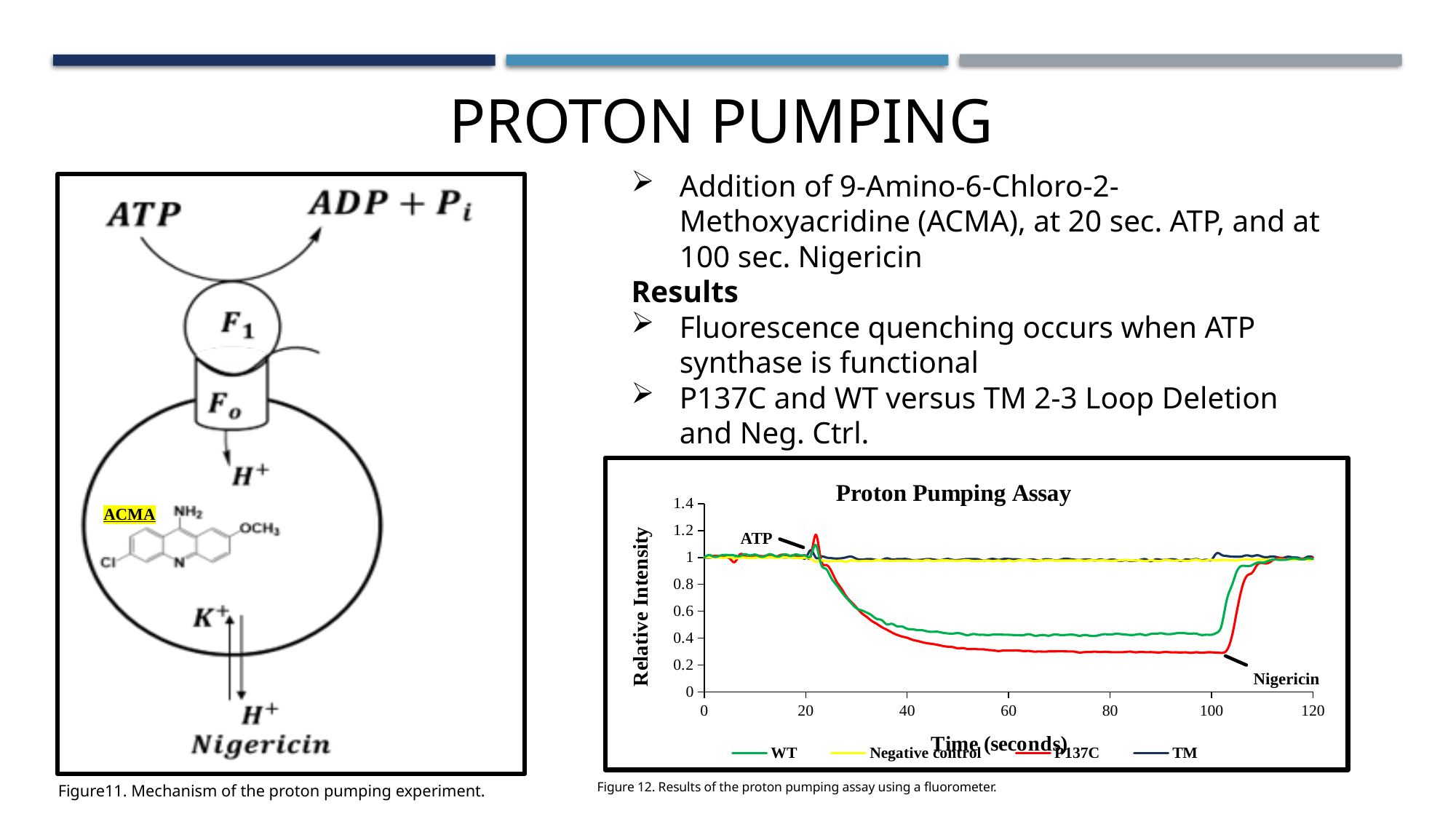
In the Proton Pumping Assay chart, is the value for WT at 60 seconds greater or less than 0.6? less In the Proton Pumping Assay chart, which is higher at 60 seconds, WT or P137C? WT In the Proton Pumping Assay chart, is the value for TM at 80 seconds greater or less than 0.6? greater In the Proton Pumping Assay chart, is the value for P137C at 60 seconds greater or less than 0.4? less What kind of chart is the Proton Pumping Assay? line chart What is the title of the chart on the slide? Proton Pumping Assay What is the label of the x axis of the Proton Pumping Assay chart? Time (seconds) How many series does the legend of the Proton Pumping Assay chart list? 4 In the Proton Pumping Assay chart, does the WT series rise or fall between 20 and 40 seconds? fall In the Proton Pumping Assay chart, does the P137C series rise or fall between 100 and 110 seconds? rise In the Proton Pumping Assay chart, which series reaches the lowest relative intensity? P137C